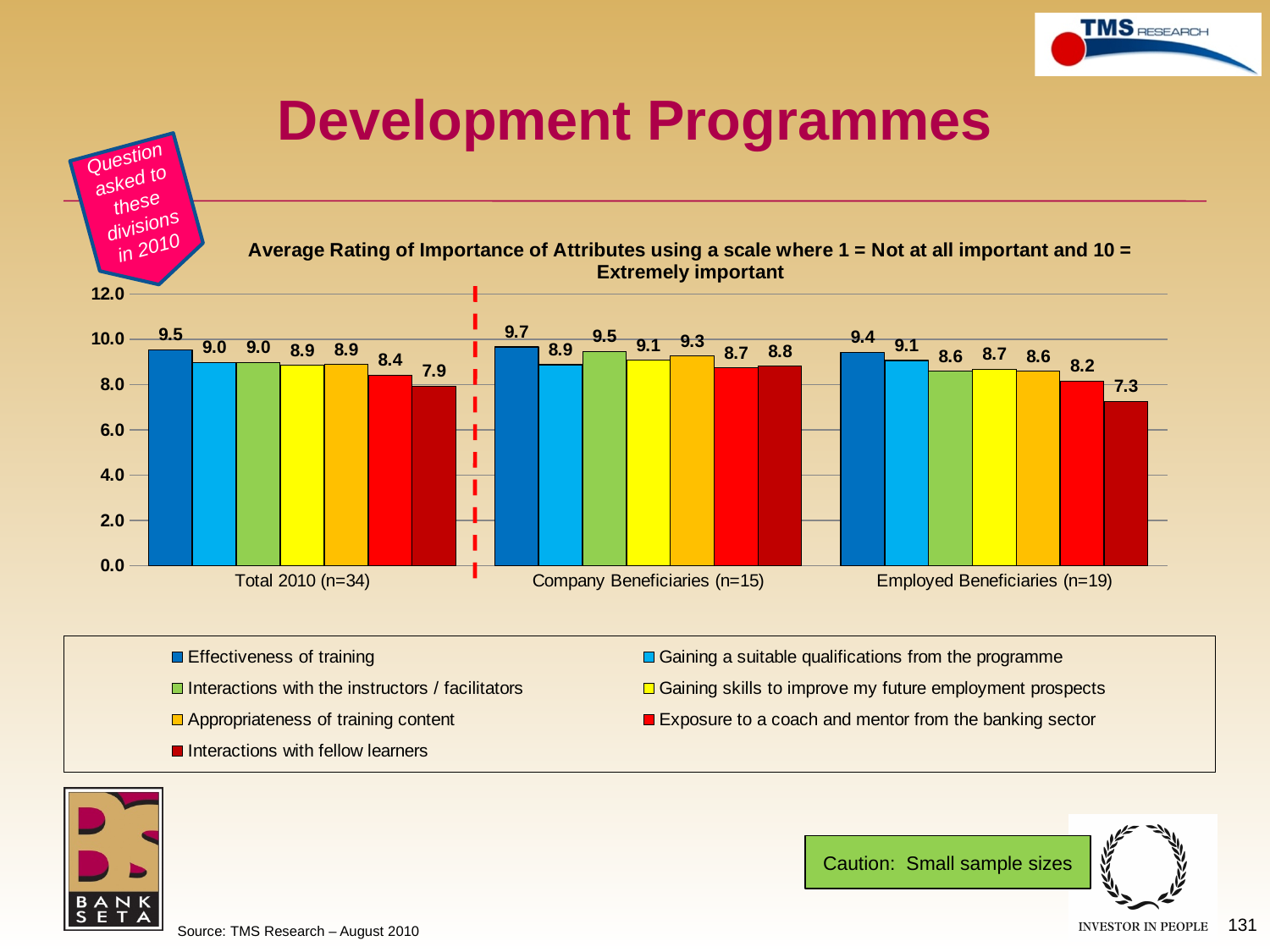
What is the value for Interactions with fellow learners in the Employed Beneficiaries (n=19) group? 7.3 What kind of chart is shown on the slide? Bar chart What is the difference between Effectiveness of training and Interactions with fellow learners in the Employed Beneficiaries (n=19) group? 2.1 Is the value for Interactions with fellow learners in the Total 2010 (n=34) group greater or less than 8.0? less How many groups are shown on the x axis? 3 Which is larger: Exposure to a coach and mentor from the banking sector for Company Beneficiaries (n=15) or for Employed Beneficiaries (n=19)? Company Beneficiaries (n=15) Which attribute has the lowest rating in the Total 2010 (n=34) group? Interactions with fellow learners Which colour represents Interactions with the instructors / facilitators in the legend? Green What is the value for Appropriateness of training content in the Company Beneficiaries (n=15) group? 9.3 How many series does the legend list? 7 Which attribute has the highest rating in the Company Beneficiaries (n=15) group? Effectiveness of training What is the value for Effectiveness of training in the Total 2010 (n=34) group? 9.5